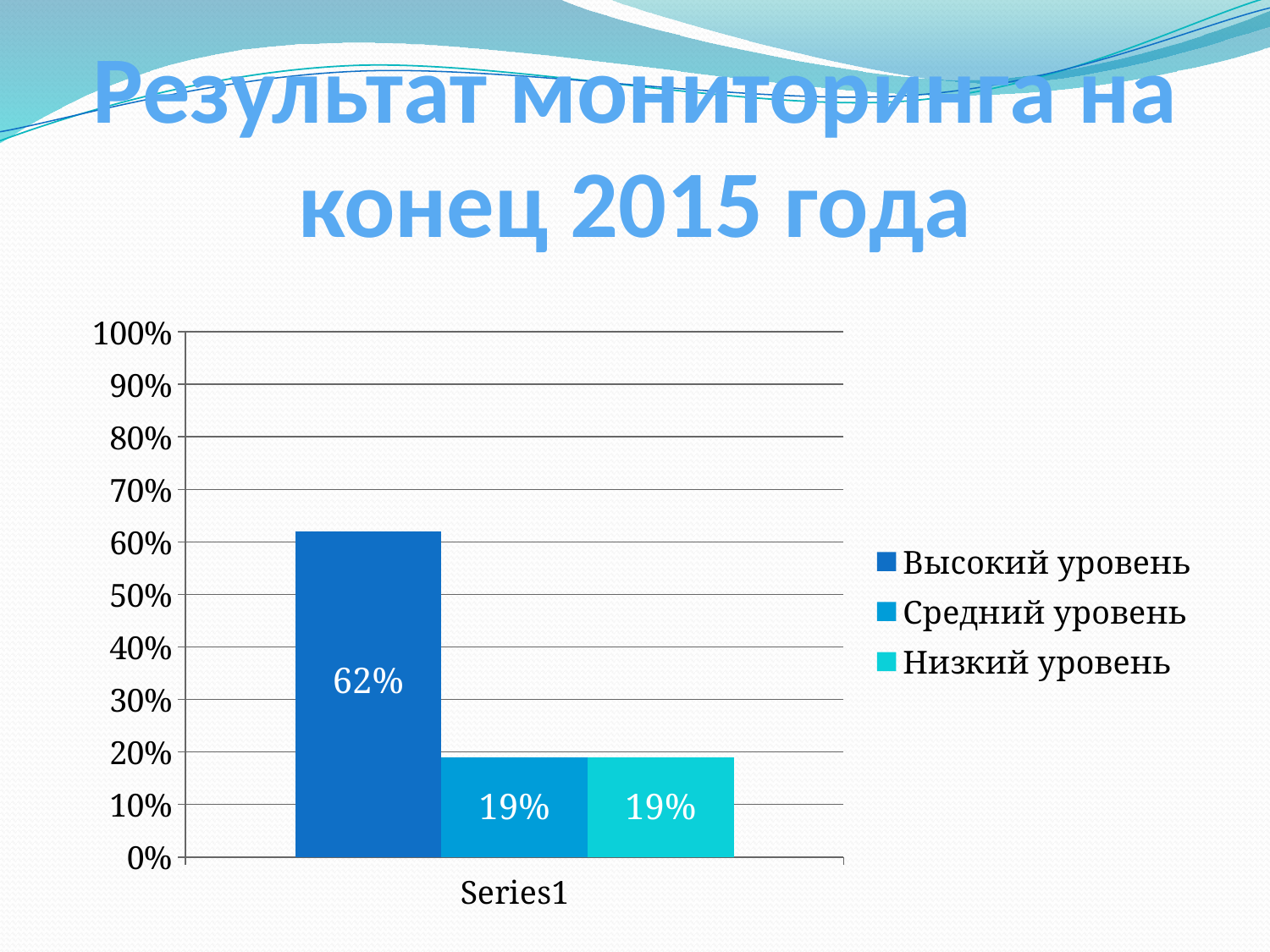
Is the value for Высокий уровень greater or less than 50%? greater What is the title of the slide? Результат мониторинга на конец 2015 года What is the value for Высокий уровень? 62% What is the label on the x axis under the bars? Series1 Is the value for Средний уровень greater or less than 30%? less How many series does the legend list? 3 Which series has the highest value? Высокий уровень What is the difference between the values for Высокий уровень and Средний уровень? 43% What is the value for Средний уровень? 19% What kind of chart is shown on the slide? bar chart What is the value for Низкий уровень? 19% Which is larger, the value for Высокий уровень or the value for Низкий уровень? Высокий уровень